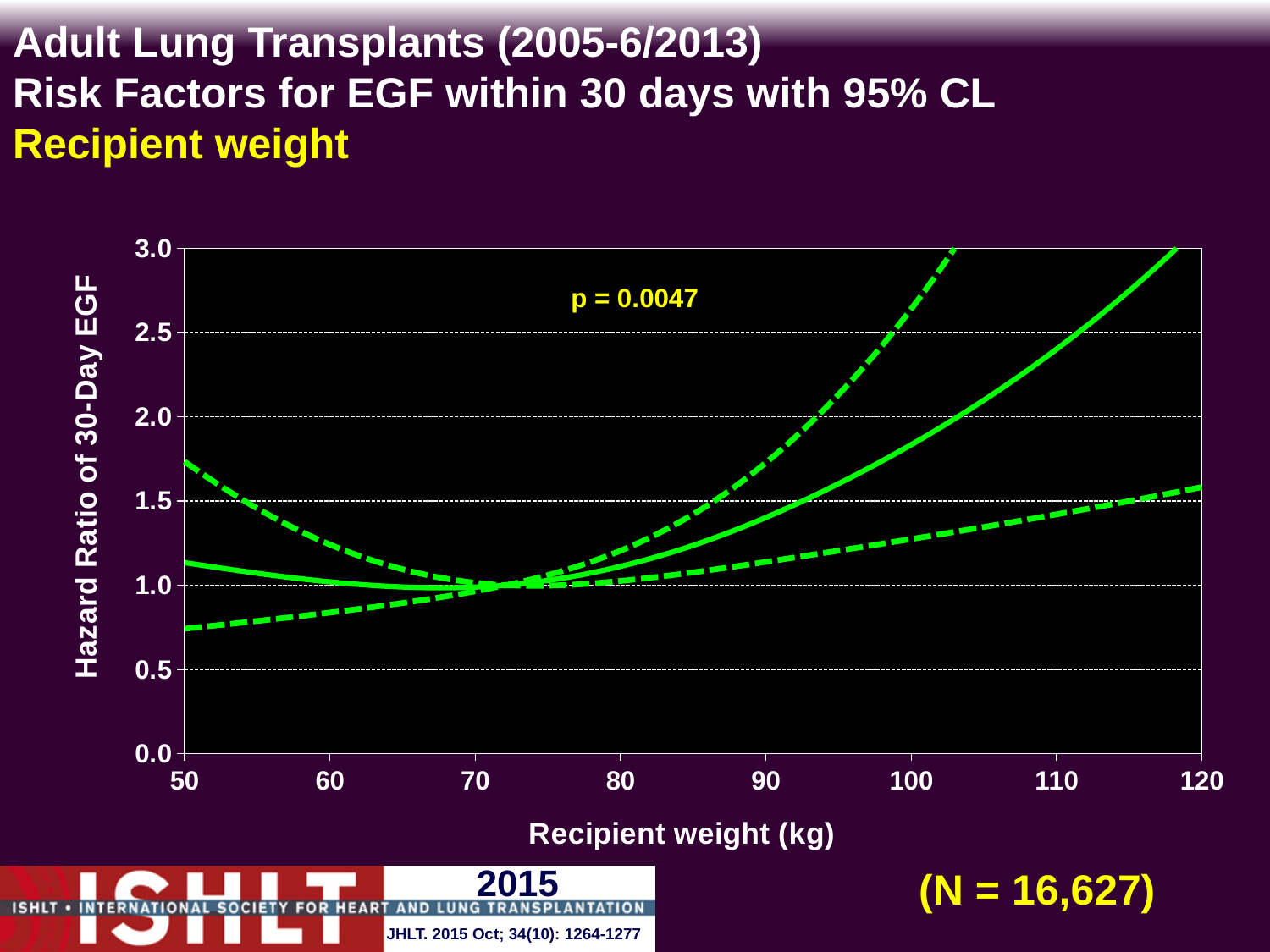
What is the label of the x axis? Recipient weight (kg) Does the solid hazard ratio line rise or fall as recipient weight increases from 70 kg to 120 kg? rise What p-value is printed on the chart? p = 0.0047 Is the lower dashed confidence limit at a recipient weight of 50 kg greater or less than 1.0? less Is the upper dashed confidence limit at a recipient weight of 100 kg greater or less than 2.0? greater Does the upper dashed confidence limit rise or fall as recipient weight increases from 50 kg to 70 kg? fall Is the solid hazard ratio line at a recipient weight of 90 kg greater or less than 1.5? less What is the sample size (N) shown on the slide? N = 16,627 What kind of chart is shown on the slide? line chart How many lines are plotted on the chart? 3